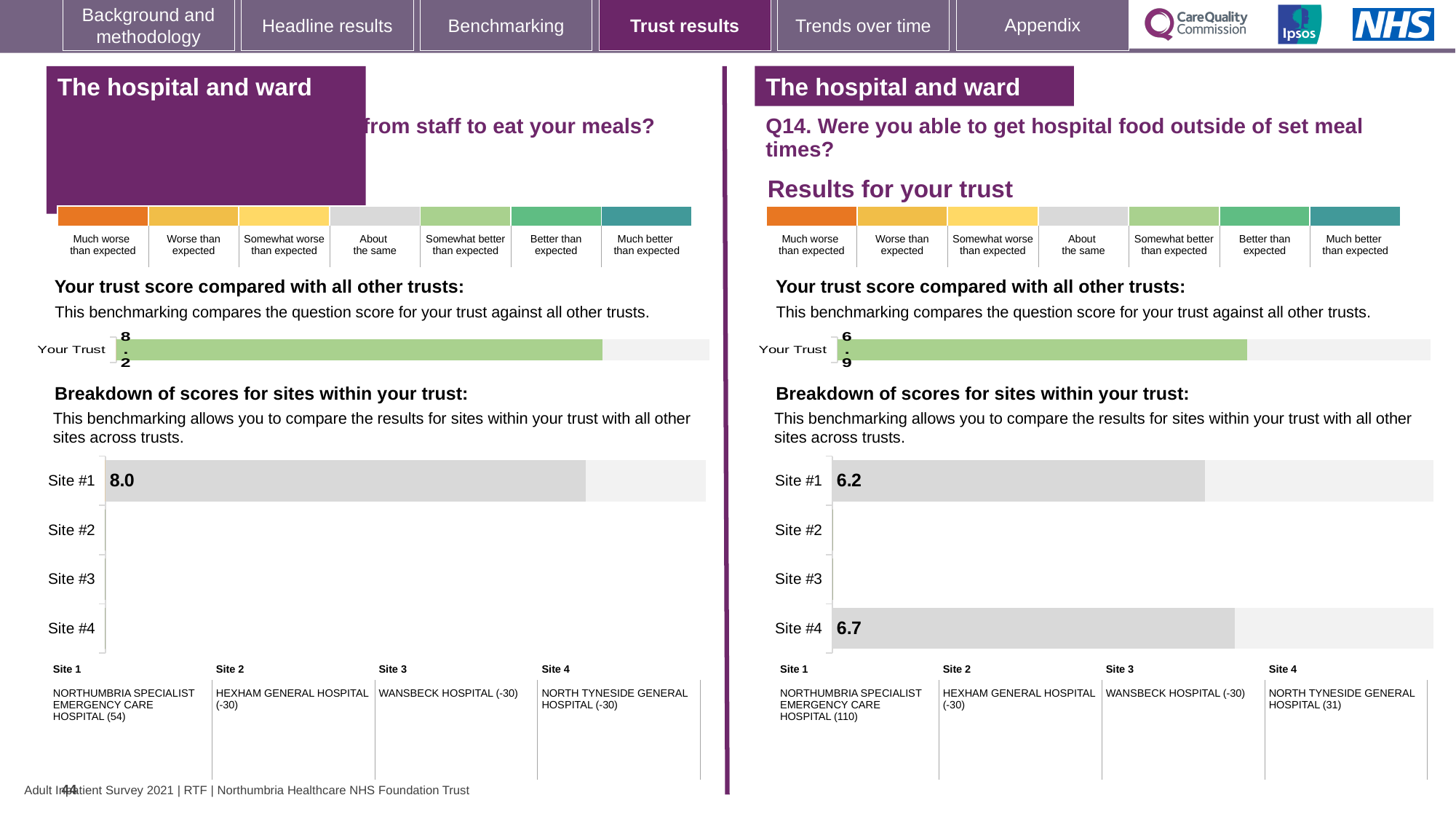
In the right-hand site breakdown chart (Q14), how many sites have a score bar plotted? 2 In the left-hand 'Your trust score compared with all other trusts' chart, what is the score for Your Trust? 8.2 In the right-hand site breakdown chart (Q14), which has the higher score, Site #1 or Site #4? Site #4 In the right-hand 'Breakdown of scores for sites within your trust' chart (Q14), what is the score for Site #1? 6.2 Which 'Your Trust' score is larger, the one on the left-hand chart or the one on the right-hand chart (Q14)? The left-hand chart In the left-hand 'Your trust score compared with all other trusts' chart, what colour is the Your Trust bar? Green What kind of chart is used for the 'Breakdown of scores for sites within your trust' on the right-hand side (Q14)? Bar chart How many site categories are listed on the axis of the right-hand site breakdown chart (Q14)? 4 In the left-hand 'Breakdown of scores for sites within your trust' chart, what is the score for Site #1? 8.0 In the right-hand 'Breakdown of scores for sites within your trust' chart (Q14), what is the score for Site #4? 6.7 In the right-hand site breakdown chart (Q14), what is the difference between the scores for Site #4 and Site #1? 0.5 In the right-hand 'Your trust score compared with all other trusts' chart (Q14), what is the score for Your Trust? 6.9